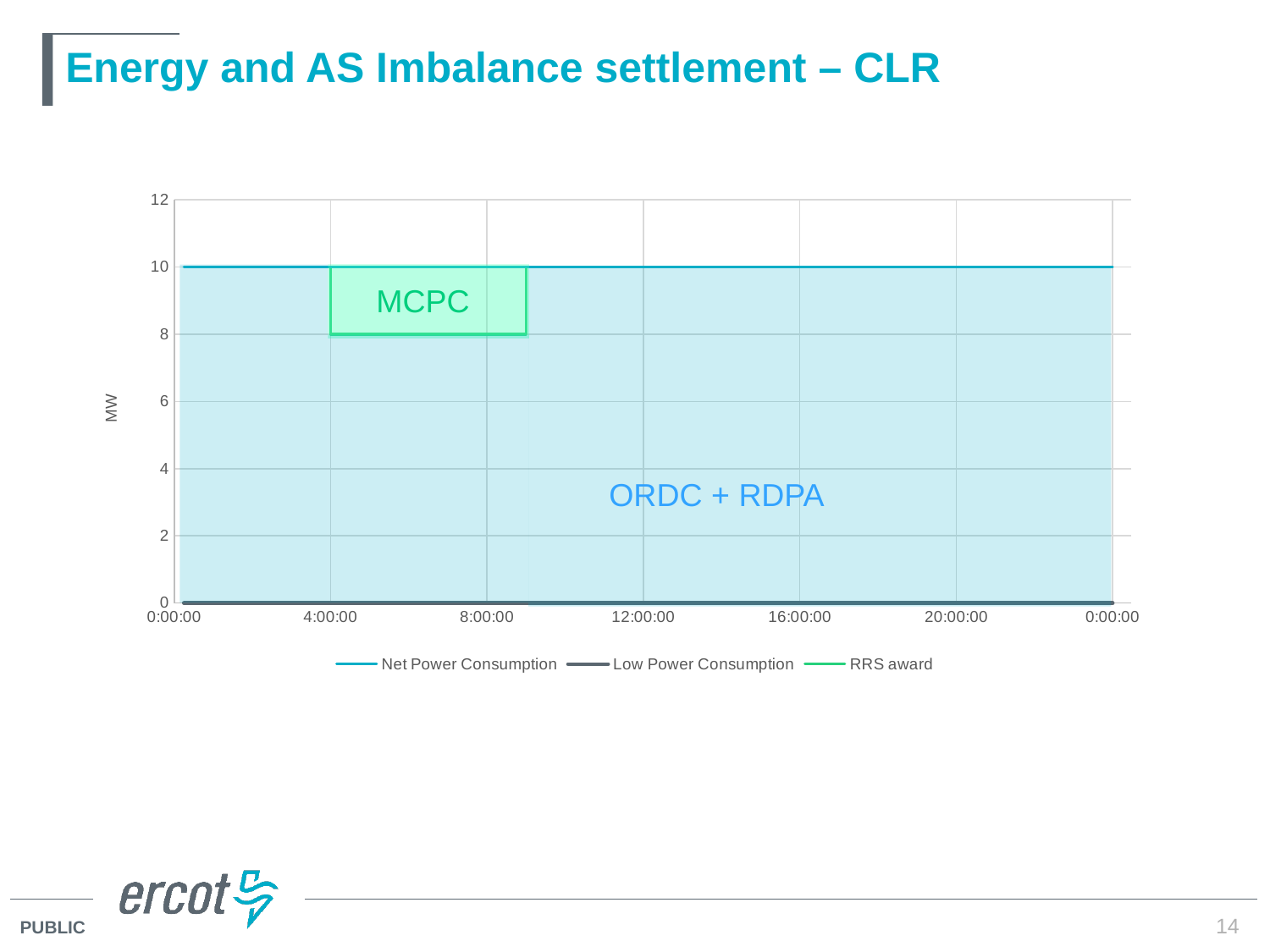
What is the value of Low Power Consumption in MW? 0 What label is printed inside the green RRS award box? MCPC What is the label on the y axis? MW How many series does the legend list? 3 At what MW value does the bottom edge of the RRS award box sit? 8 Which is larger, Net Power Consumption or Low Power Consumption? Net Power Consumption What kind of chart is shown on the slide? line chart What is the difference between Net Power Consumption and Low Power Consumption in MW? 10 Does Net Power Consumption rise, fall or stay flat across the day? stays flat Is the value for Net Power Consumption greater or less than 6? greater At what time does the RRS award box begin? 4:00:00 What is the value of Net Power Consumption in MW? 10